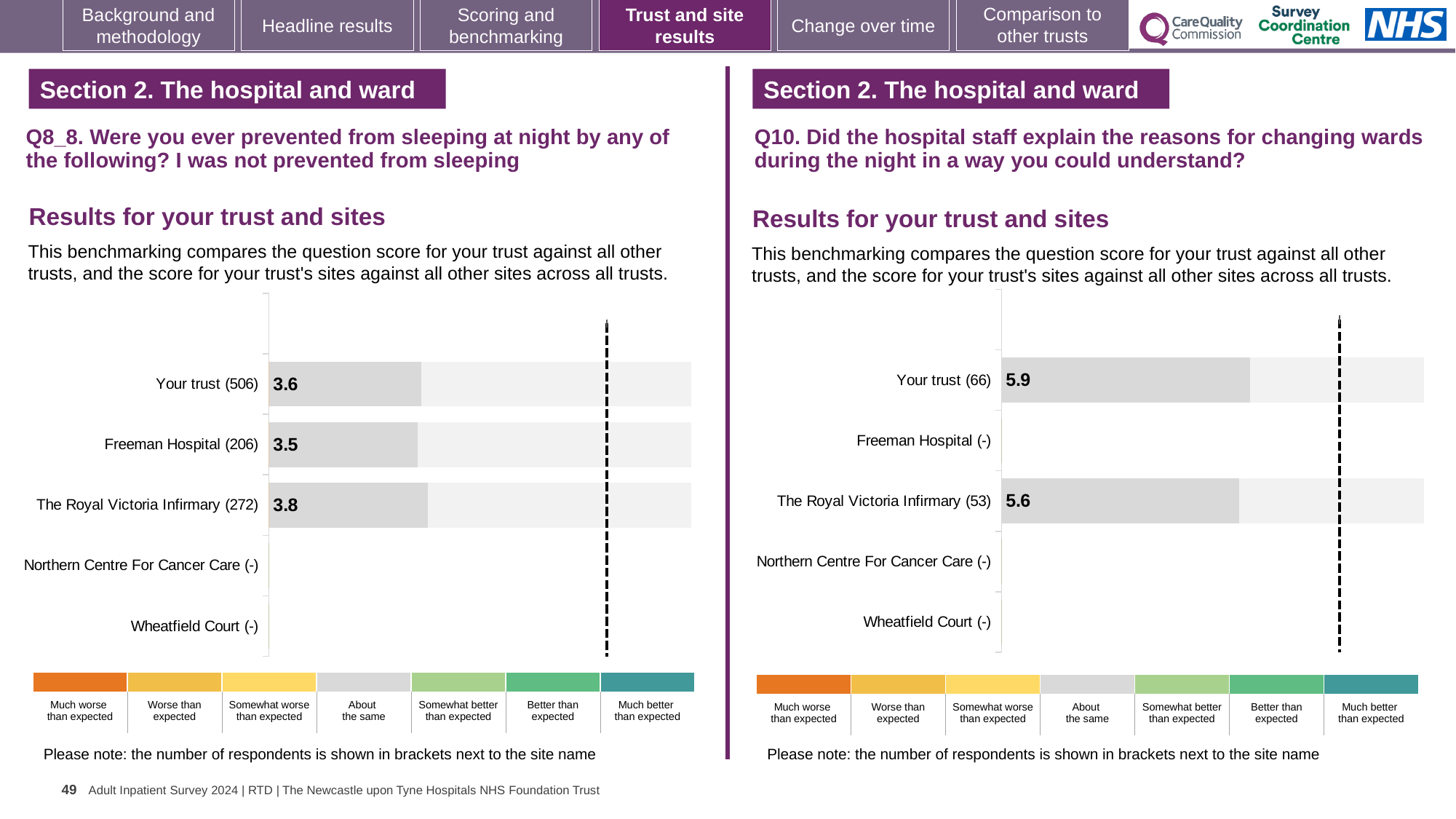
What kind of chart is used on the Q10 chart (right)? Bar chart On the Q8_8 chart (left), which site has the highest score? The Royal Victoria Infirmary On the Q10 chart (right), which is larger, the score for Your trust or for The Royal Victoria Infirmary? Your trust On the Q8_8 chart (left), what is the score for Your trust? 3.6 On the Q8_8 chart (left), what is the score for The Royal Victoria Infirmary? 3.8 On the Q8_8 chart (left), how many site rows are listed on the vertical axis? 5 On the Q10 chart (right), what is the score for The Royal Victoria Infirmary? 5.6 On the Q8_8 chart (left), how many respondents are shown for Your trust? 506 On the Q8_8 chart (left), what is the difference between the scores for The Royal Victoria Infirmary and Freeman Hospital? 0.3 On the Q10 chart (right), what is the score for Your trust? 5.9 On the Q8_8 chart (left), what is the score for Freeman Hospital? 3.5 On the Q10 chart (right), what is the difference between the scores for Your trust and The Royal Victoria Infirmary? 0.3